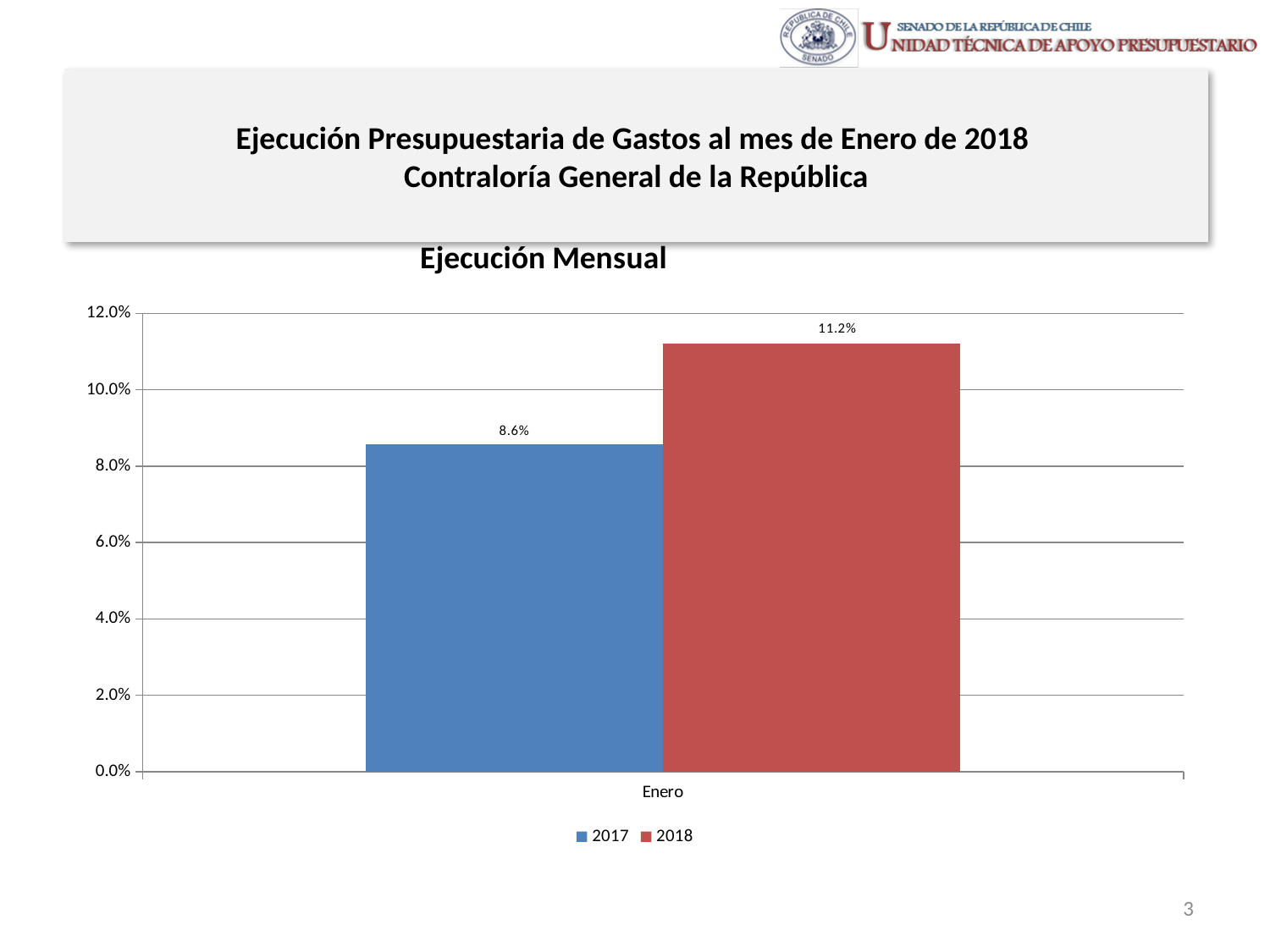
Is the value for 2018 in Enero greater or less than 10.0%? greater Is the value for 2017 in Enero greater or less than 10.0%? less What kind of chart is shown on the slide? Bar chart Which series has the higher value for Enero, 2017 or 2018? 2018 What is the difference between the 2018 and 2017 values for Enero? 2.6% Which series has the lowest value in the chart? 2017 What is the title of the chart? Ejecución Mensual How many series does the legend list? 2 Which colour represents the 2018 series? Red What is the value for 2017 in Enero? 8.6% What is the value for 2018 in Enero? 11.2% How many categories are shown on the x axis? 1